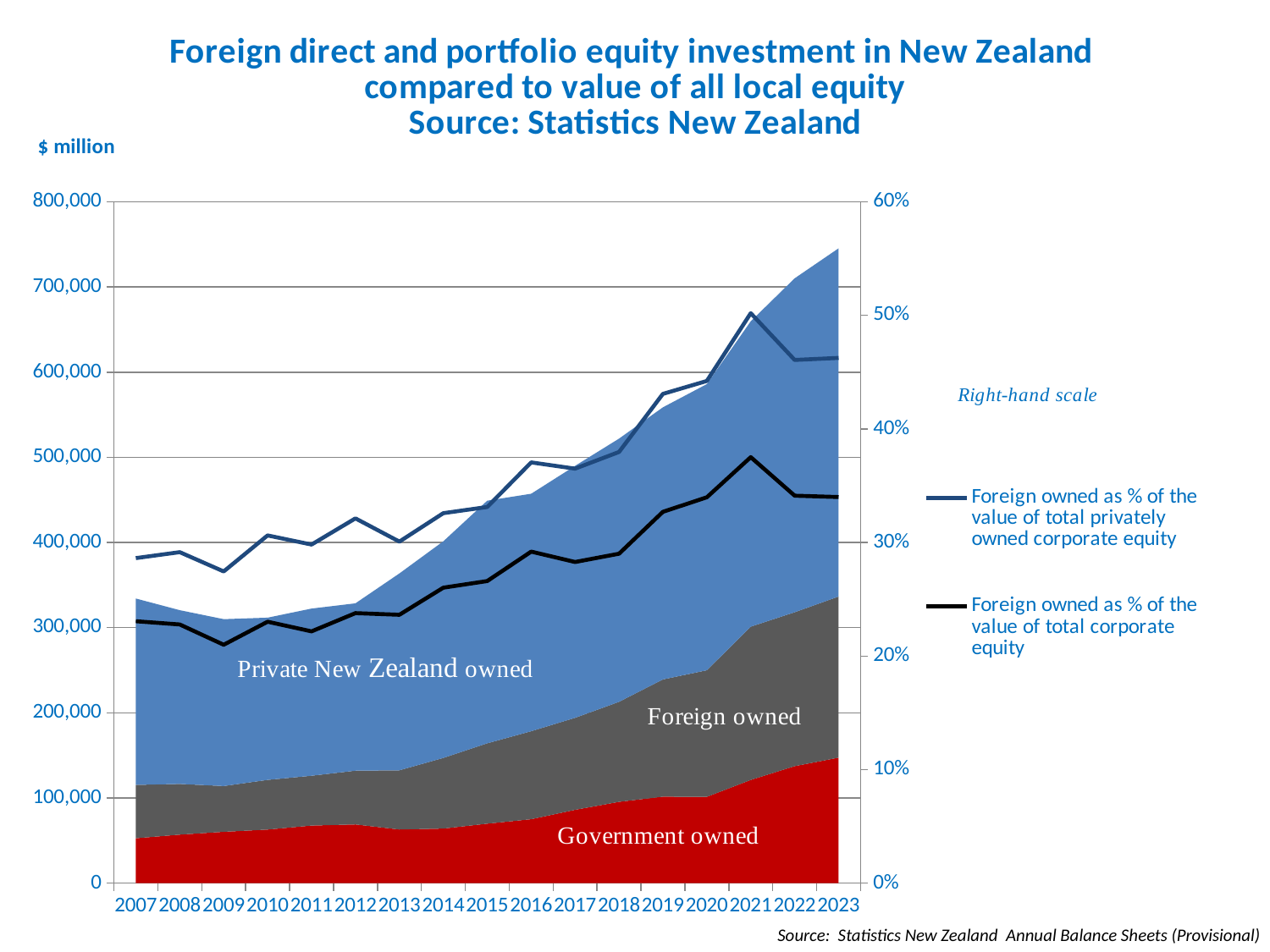
What kind of chart is shown on the slide? A stacked area chart combined with line series In which year is the 'Foreign owned as % of the value of total privately owned corporate equity' line at its lowest? 2009 Is the value of 'Foreign owned as % of the value of total corporate equity' in 2009 greater or less than 30%? less How many years are shown along the x axis? 17 Does the total value of the stacked areas generally rise or fall from 2007 to 2023? rise Is the value of 'Foreign owned as % of the value of total privately owned corporate equity' in 2021 greater or less than 40%? greater In 2023, which line is higher: 'Foreign owned as % of the value of total privately owned corporate equity' or 'Foreign owned as % of the value of total corporate equity'? Foreign owned as % of the value of total privately owned corporate equity Is the value of 'Foreign owned as % of the value of total corporate equity' in 2021 greater or less than 30%? greater In which year does the 'Foreign owned as % of the value of total corporate equity' line reach its highest value? 2021 What is the first year shown on the x axis? 2007 How many series does the legend list? 2